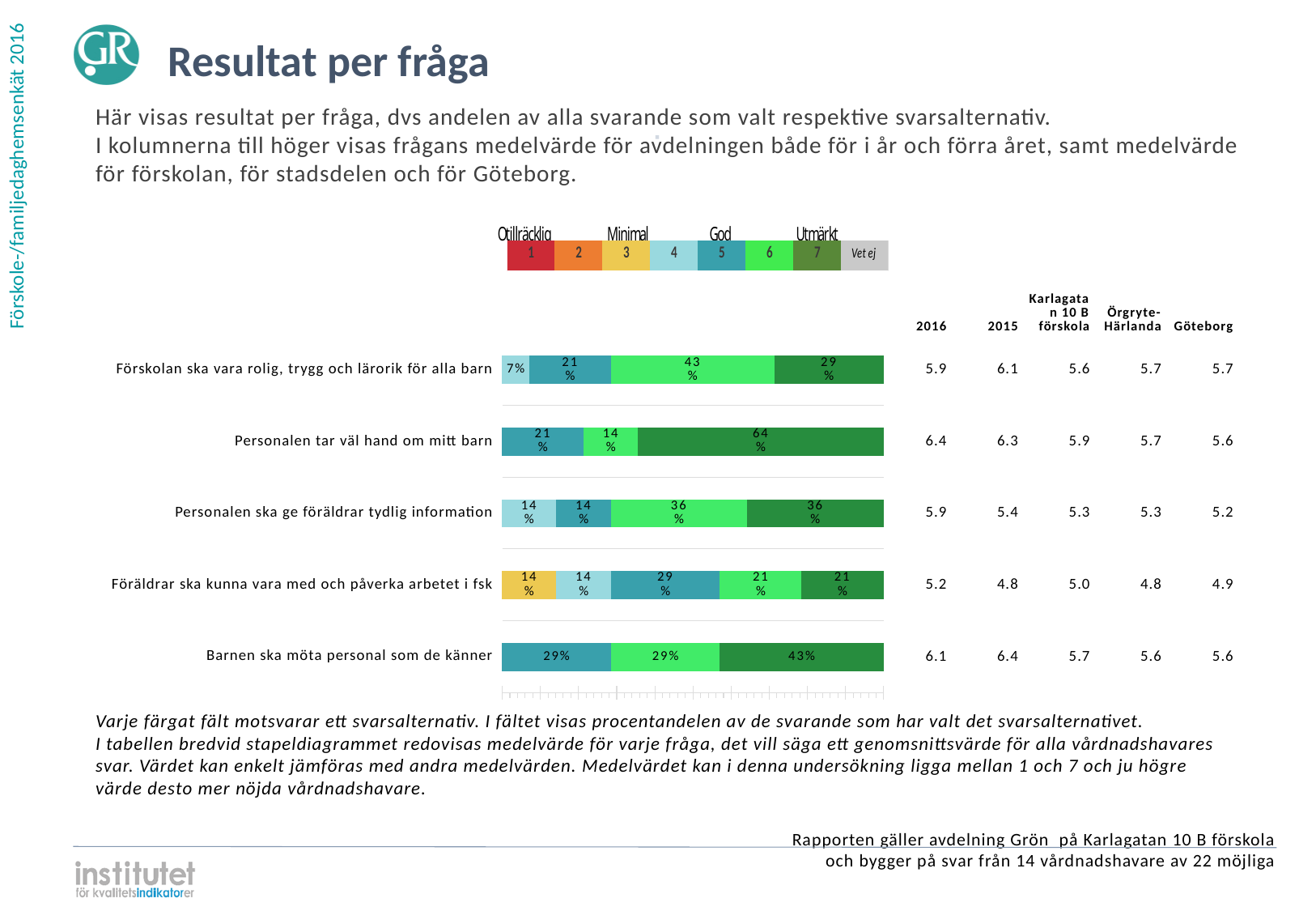
Which question has the largest share of respondents choosing alternative 7 (dark green)? Personalen tar väl hand om mitt barn What kind of chart is used to show the results per question? Stacked bar chart What is the difference between the share choosing alternative 7 for 'Barnen ska möta personal som de känner' (43%) and for 'Förskolan ska vara rolig, trygg och lärorik för alla barn' (29%)? 14 percentage points What percentage chose alternative 3 (yellow) for 'Föräldrar ska kunna vara med och påverka arbetet i fsk'? 14% What percentage of respondents chose the highest alternative (7, dark green) for 'Personalen tar väl hand om mitt barn'? 64% Which question has the smallest share of respondents choosing alternative 7 (dark green)? Föräldrar ska kunna vara med och påverka arbetet i fsk For 'Personalen ska ge föräldrar tydlig information', is the share choosing alternative 6 larger or smaller than the share choosing alternative 5? Larger Which colour represents answer alternative 7 in the legend? Dark green How many questions (categories) are shown in the bar chart? 5 What is the 2016 mean value shown for 'Personalen tar väl hand om mitt barn'? 6.4 What percentage chose alternative 6 (bright green) for 'Förskolan ska vara rolig, trygg och lärorik för alla barn'? 43% How many answer alternatives does the legend above the chart list? 8